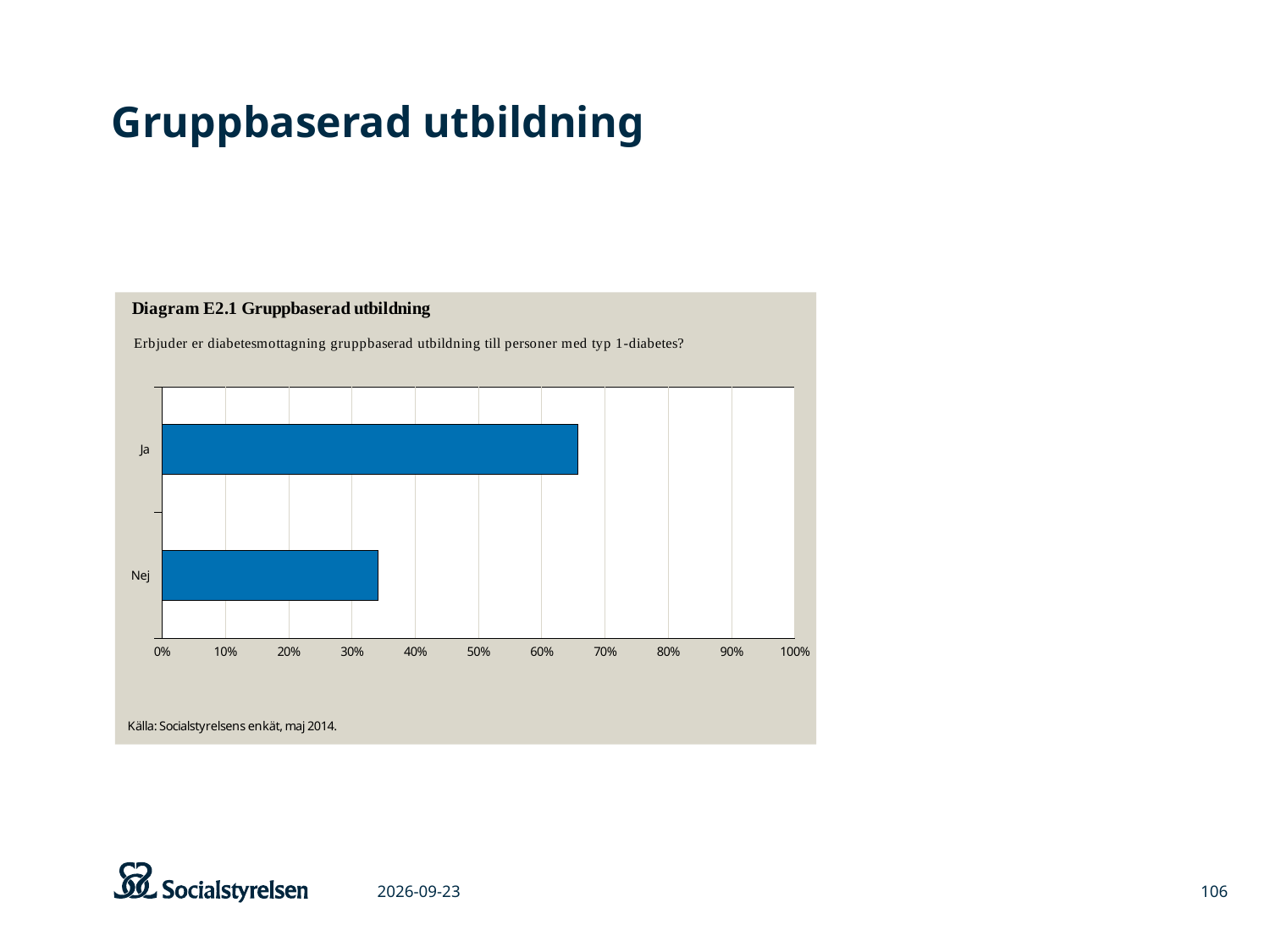
What is the highest value shown on the x axis of the chart? 100% What kind of chart is shown on the slide? bar chart Which category has the highest value? Ja Which category has the lowest value? Nej Is the value for Ja greater or less than 60%? greater Is the value for Nej greater or less than 40%? less What is the title of the chart? Diagram E2.1 Gruppbaserad utbildning Is the value for Ja greater or less than 50%? greater How many categories are plotted in the chart? 2 Which is larger, the value for Ja or the value for Nej? Ja